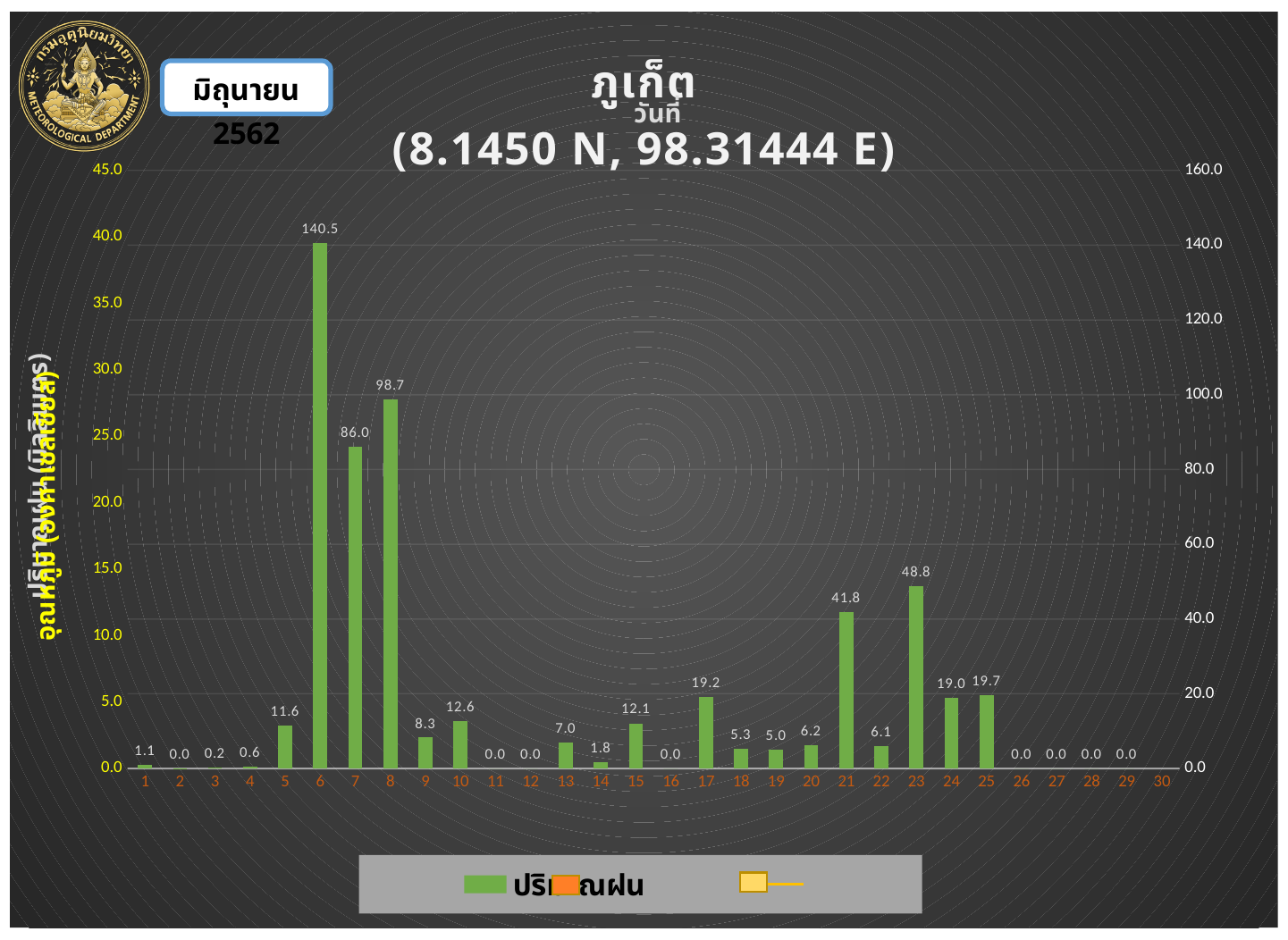
What is the difference between the rainfall values for day 6 and day 7? 54.5 What kind of chart is shown on the slide? bar chart What is the rainfall value for day 17? 19.2 How many days are shown on the x axis? 30 What is the rainfall value for day 8? 98.7 What is the rainfall value for day 6? 140.5 Which day has the highest rainfall value? 6 Which is larger, the rainfall value for day 25 or for day 24? day 25 What is the difference between the rainfall values for day 23 and day 21? 7.0 What coordinates are given in the chart title? 8.1450 N, 98.31444 E Which is larger, the rainfall value for day 8 or for day 7? day 8 What is the rainfall value for day 23? 48.8